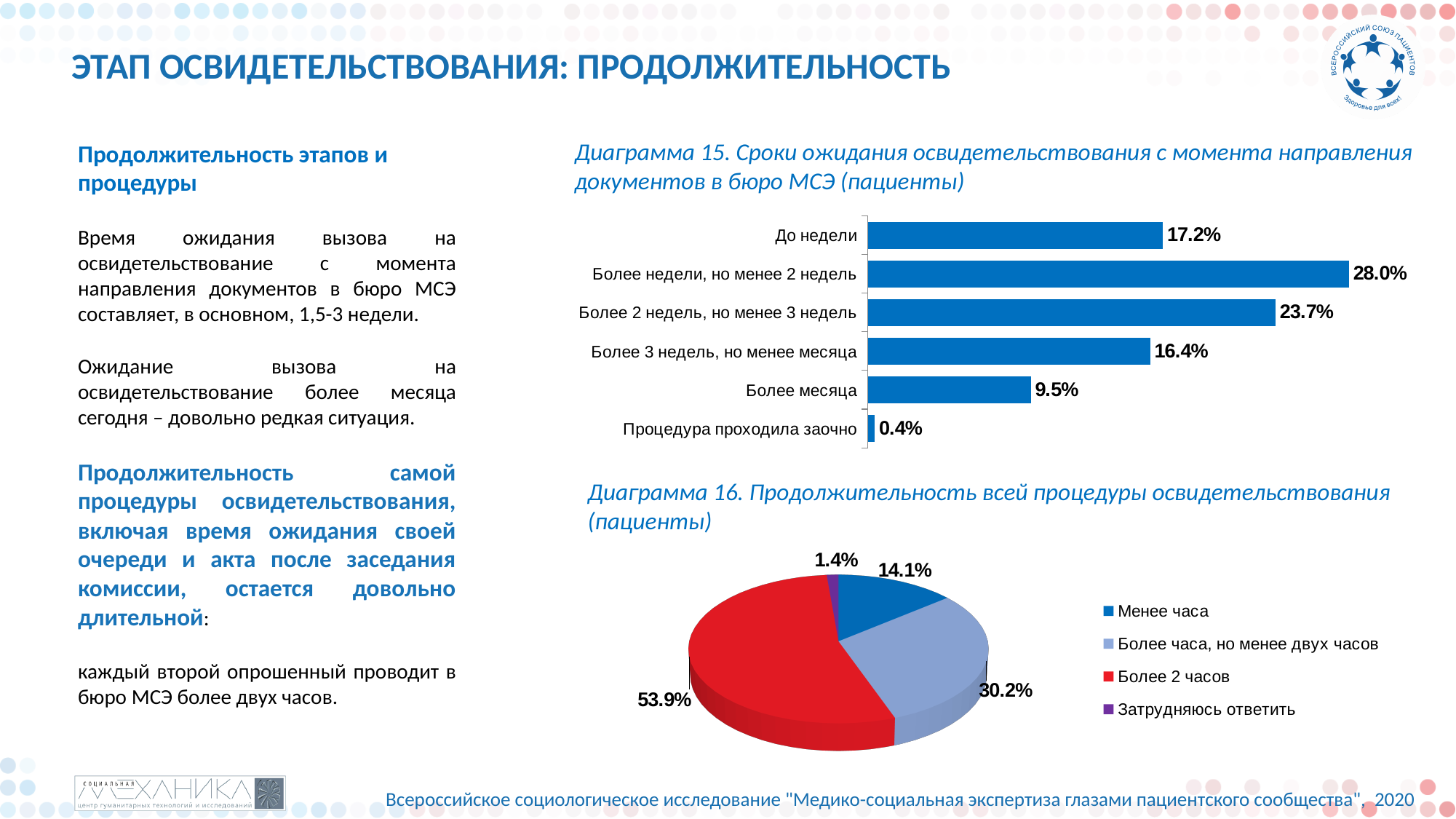
In Диаграмма 15, which is larger: 'До недели' or 'Более 3 недель, но менее месяца'? До недели How many categories are shown in Диаграмма 15? 6 In Диаграмма 15, what is the value for 'Более недели, но менее 2 недель'? 28.0% How many entries does the legend of Диаграмма 16 list? 4 In Диаграмма 16, what colour is the 'Более 2 часов' slice? Red In Диаграмма 15, which category has the lowest value? Процедура проходила заочно In Диаграмма 15, what is the difference between 'Более 2 недель, но менее 3 недель' and 'Более месяца'? 14.2% What kind of chart is Диаграмма 15? Bar chart In Диаграмма 15, which category has the highest value? Более недели, но менее 2 недель In Диаграмма 16, what share of the pie is 'Более 2 часов'? 53.9% In Диаграмма 16, what is the value for 'Менее часа'? 14.1% In Диаграмма 16, which slice is the smallest? Затрудняюсь ответить